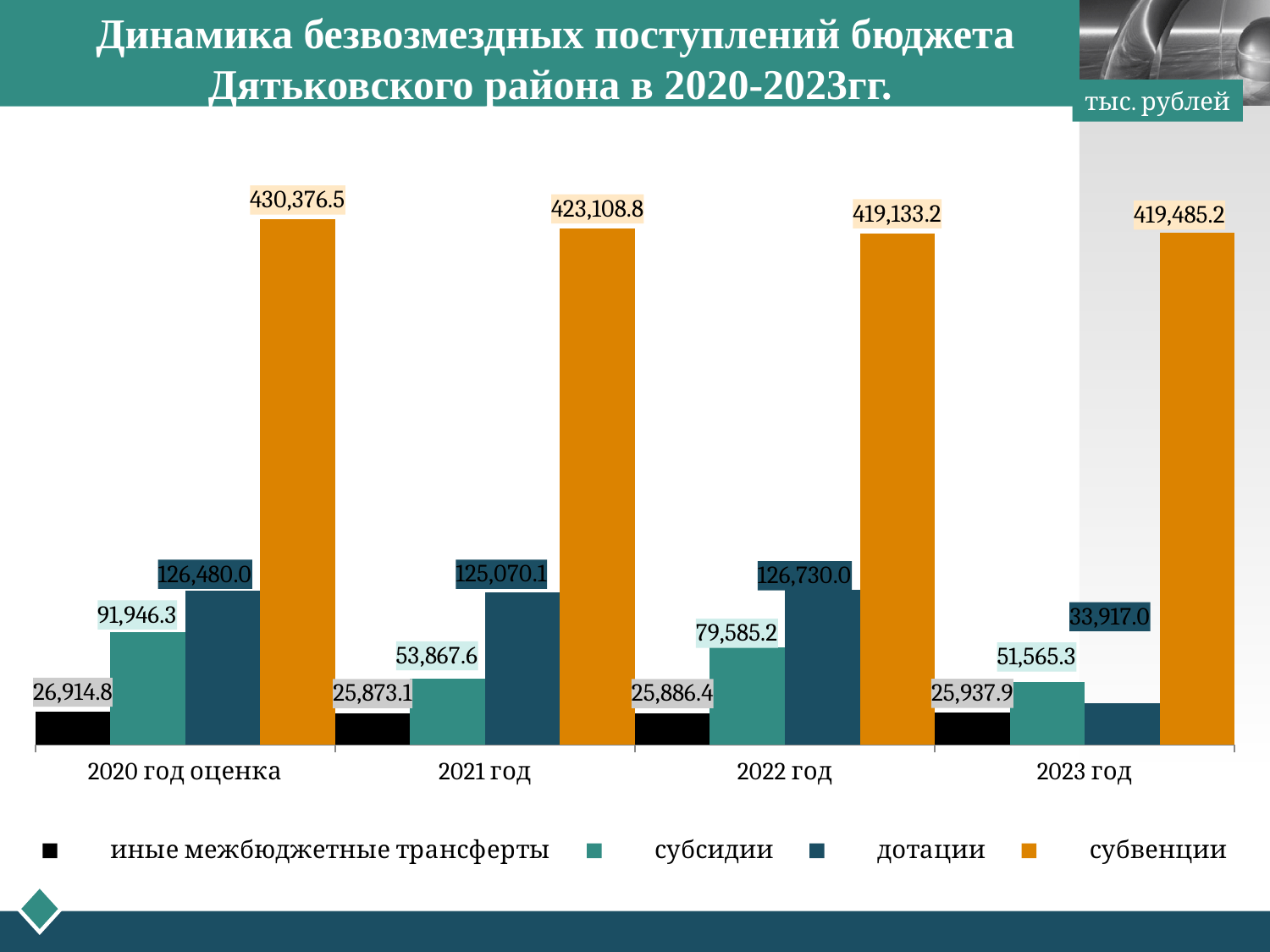
What is the value for субвенции in 2020 год оценка? 430,376.5 What is the value for иные межбюджетные трансферты in 2021 год? 25,873.1 What is the value for субсидии in 2022 год? 79,585.2 How many series does the legend list? 4 What kind of chart is shown on the slide? bar chart What is the difference between the субвенции values for 2020 год оценка and 2021 год? 7,267.7 In which year is the value for субвенции the highest? 2020 год оценка In which year is the value for субсидии the lowest? 2023 год What is the value for дотации in 2023 год? 33,917.0 Which is larger: субсидии in 2020 год оценка or субсидии in 2022 год? субсидии in 2020 год оценка How many years (categories) are shown on the x axis? 4 What is the difference between the дотации values for 2022 год and 2023 год? 92,813.0